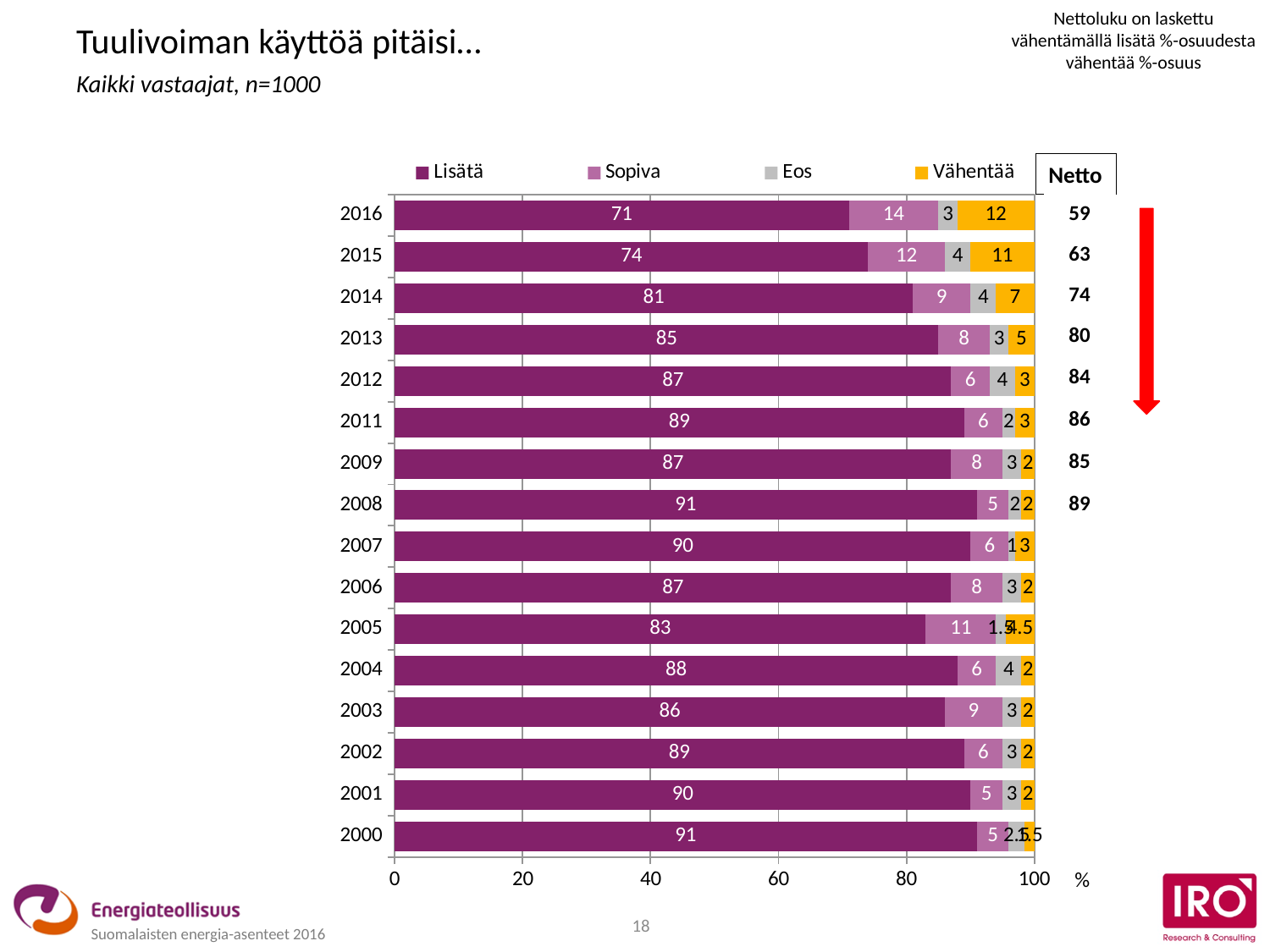
Which year has the larger "Lisätä" value, 2014 or 2016? 2014 How many series does the legend list? 4 In which year is the "Lisätä" share lowest? 2016 How many years are shown on the chart? 16 In which year is the "Vähentää" share highest? 2016 What is the "Vähentää" value for 2014? 7 What is the Netto value shown for 2016? 59 What is the difference between the "Lisätä" values for 2015 and 2016? 3 What percentage of respondents chose "Lisätä" in 2016? 71 What kind of chart is shown on the slide? Stacked bar chart What is the "Sopiva" value for 2005? 11 Does the "Lisätä" share rise or fall from 2013 to 2016? Fall